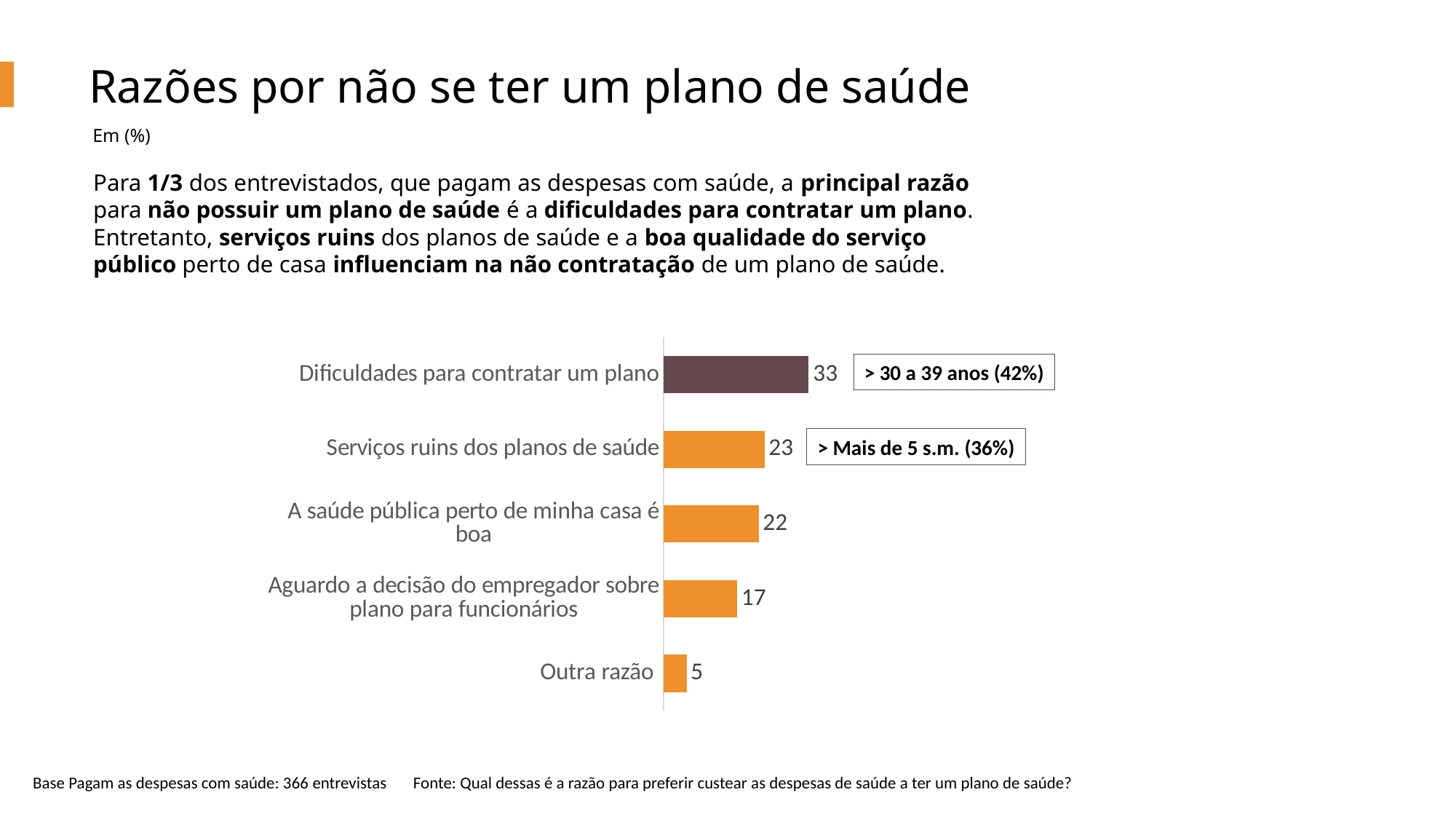
What is the value for "Outra razão"? 5 What kind of chart is shown on the slide? Bar chart Which category has the lowest value? Outra razão How many categories are shown in the chart? 5 What is the value for "Dificuldades para contratar um plano"? 33 What is the value for "Serviços ruins dos planos de saúde"? 23 What is the difference between the values for "Dificuldades para contratar um plano" and "Serviços ruins dos planos de saúde"? 10 What is the value for "A saúde pública perto de minha casa é boa"? 22 Which is larger: the value for "Aguardo a decisão do empregador sobre plano para funcionários" or the value for "Outra razão"? Aguardo a decisão do empregador sobre plano para funcionários Which bar is shown in a different colour from the others? Dificuldades para contratar um plano Which category has the highest value? Dificuldades para contratar um plano What is the value for "Aguardo a decisão do empregador sobre plano para funcionários"? 17